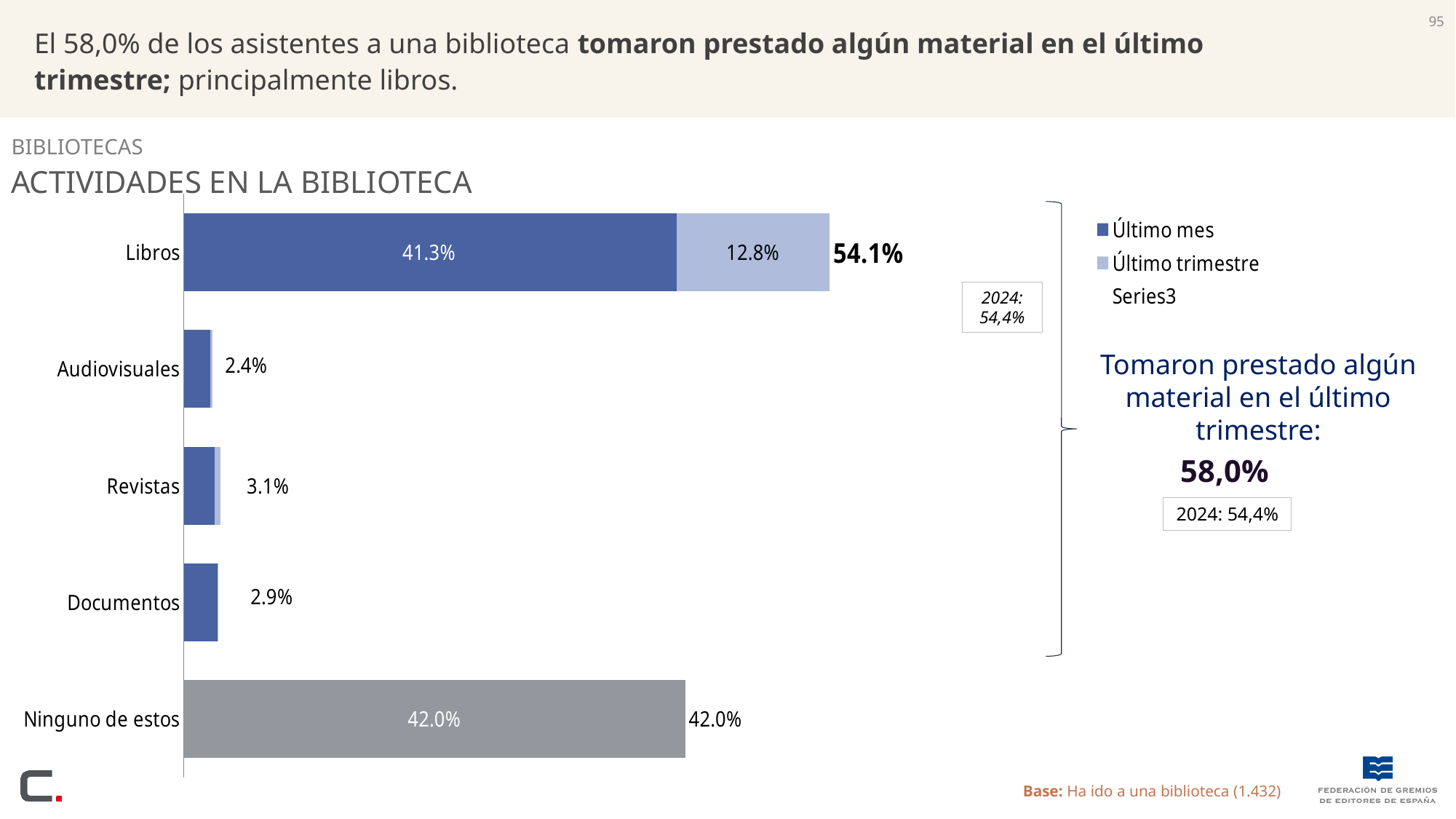
What is the total shown at the end of the Libros bar? 54.1% What is the difference between the Libros total (54.1%) and the 'Ninguno de estos' value (42.0%)? 12.1 percentage points What is the title of the chart? ACTIVIDADES EN LA BIBLIOTECA Which borrowed material category has the highest value? Libros How many series does the chart legend list? 3 Which category has the lowest value on the chart? Audiovisuales Which is larger, the value for Revistas or the value for Documentos? Revistas What is the 'Último mes' value for Libros? 41.3% What is the 'Último trimestre' value for Libros? 12.8% How many categories are plotted on the chart? 5 What kind of chart is shown on the slide? Bar chart What is the value for 'Ninguno de estos'? 42.0%